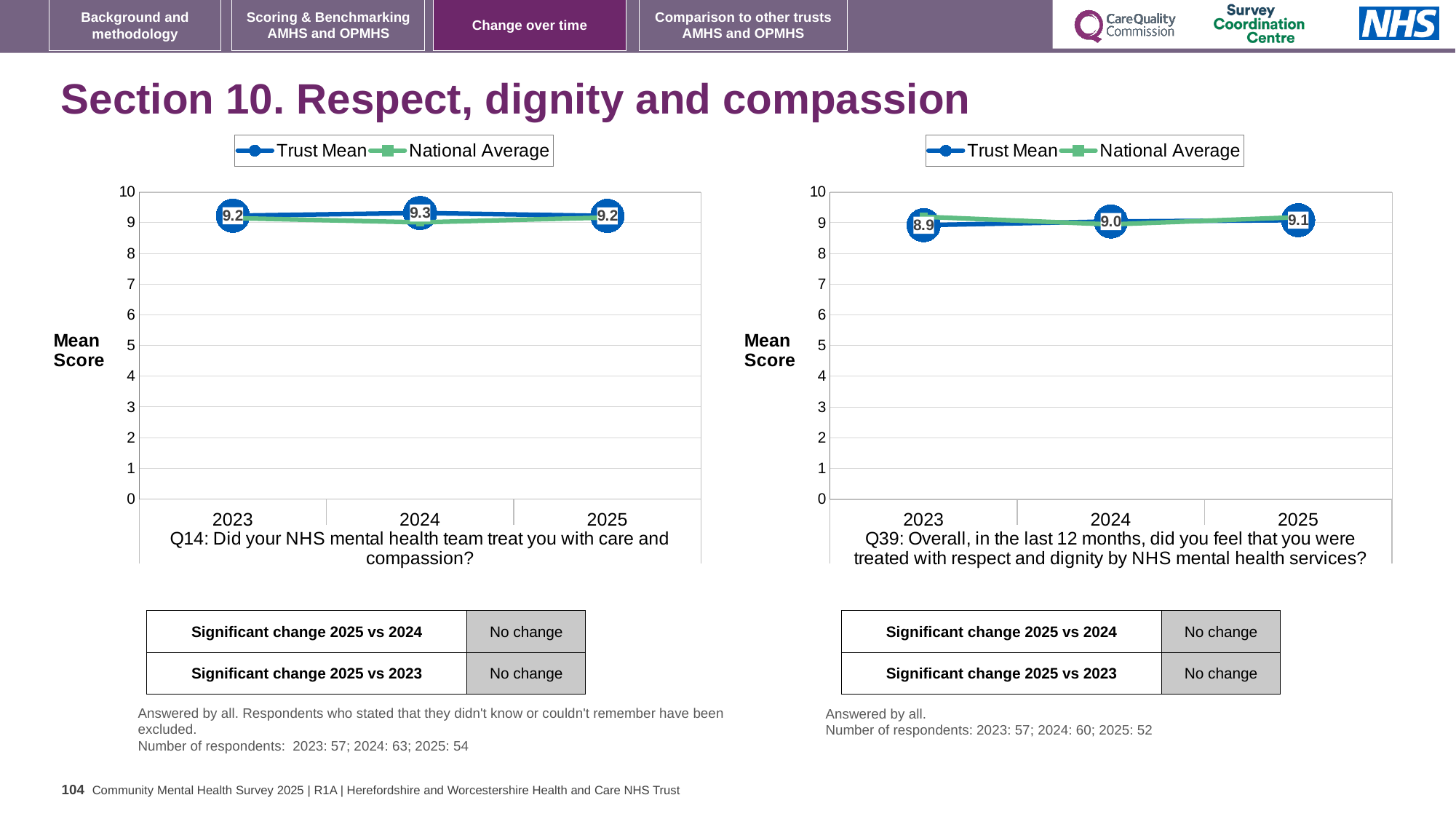
On the right chart (Q39), what is the Trust Mean score for 2023? 8.9 On the right chart (Q39), what is the Trust Mean score for 2025? 9.1 On the left chart (Q14), what is the Trust Mean score for 2024? 9.3 How many years are plotted on the left chart (Q14)? 3 On the left chart (Q14), is the Trust Mean score for 2024 larger or smaller than the score for 2025? larger On the right chart (Q39), does the Trust Mean rise or fall from 2023 to 2025? rise How many series does the legend of the right chart (Q39) list? 2 On the left chart (Q14), which year has the highest Trust Mean score? 2024 On the right chart (Q39), what is the difference between the Trust Mean scores for 2025 and 2023? 0.2 On the right chart (Q39), is the National Average value for 2023 greater or less than 8? greater On the right chart (Q39), which year has the lowest Trust Mean score? 2023 What type of chart is used for Q14 on the left? Line chart